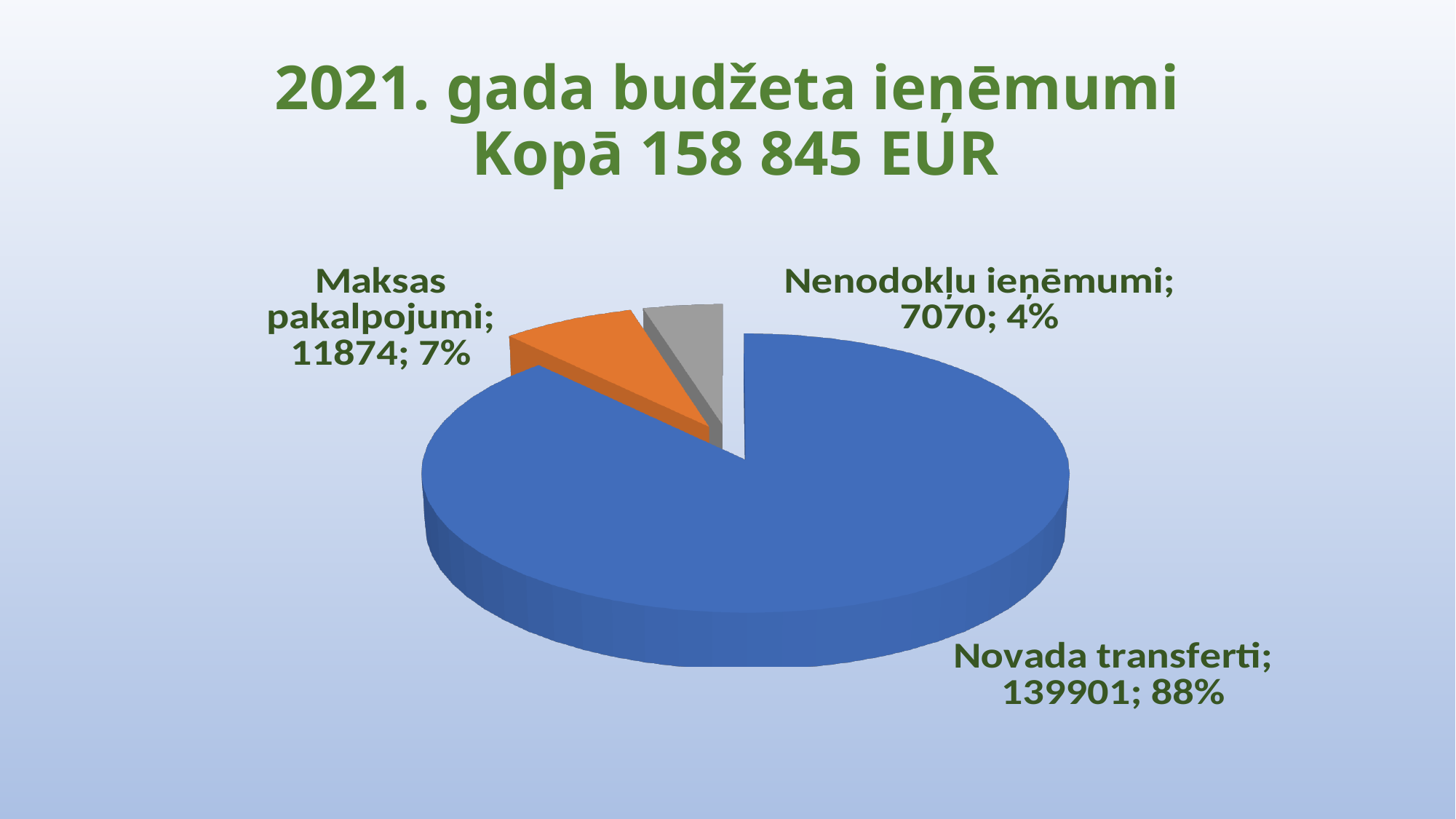
What kind of chart is shown on the slide? pie chart What share of the pie does Nenodokļu ieņēmumi represent? 4% What share of the pie does Maksas pakalpojumi represent? 7% What is the title of the chart? 2021. gada budžeta ieņēmumi Kopā 158 845 EUR What is the value for Maksas pakalpojumi? 11874 Which category has the largest slice? Novada transferti What is the value for Nenodokļu ieņēmumi? 7070 What is the difference between the values for Maksas pakalpojumi and Nenodokļu ieņēmumi? 4804 How many slices does the pie chart have? 3 What share of the pie does Novada transferti represent? 88% What is the value for Novada transferti? 139901 Which category has the smallest slice? Nenodokļu ieņēmumi